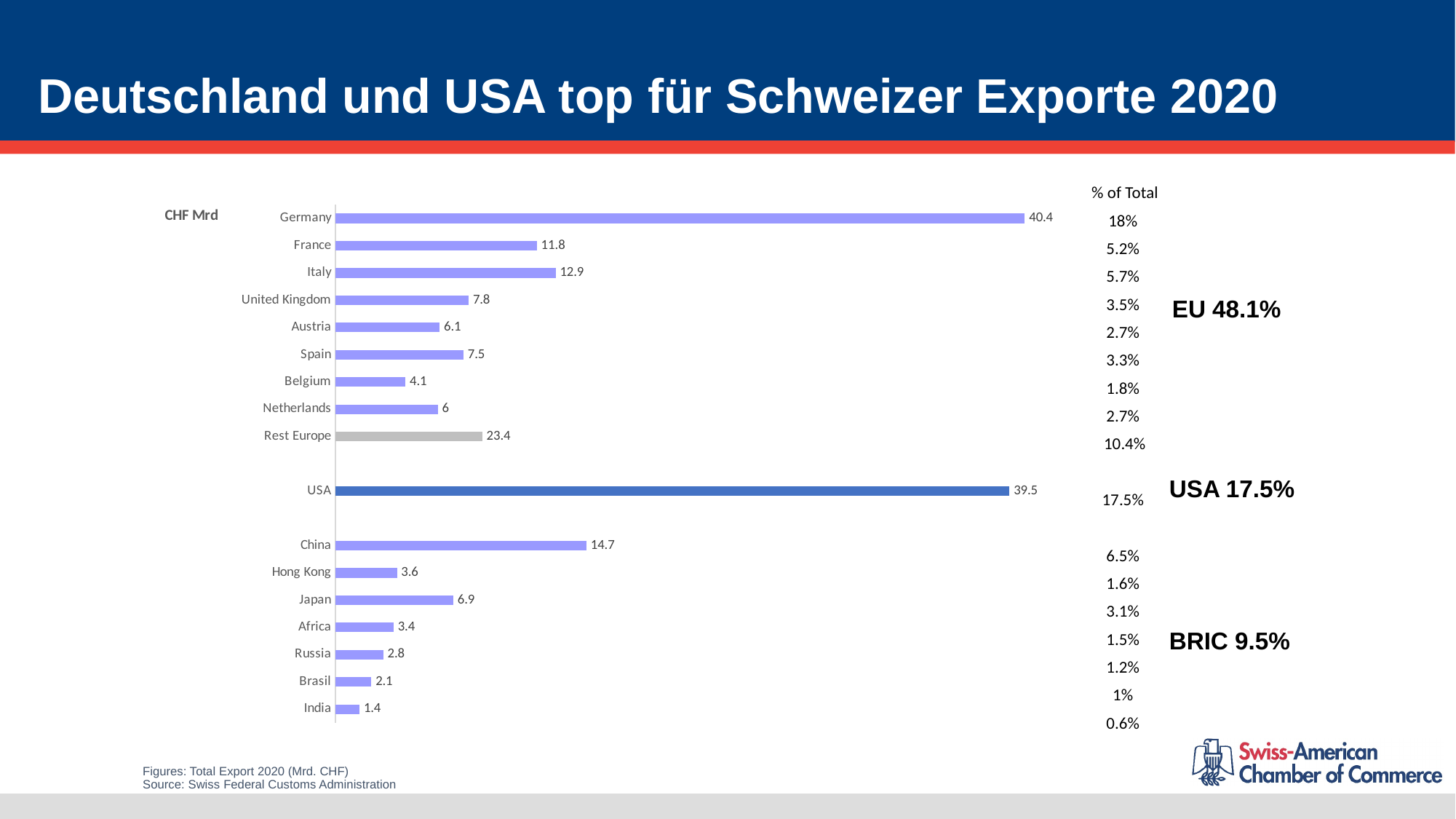
What is the difference between the export values for Germany and the USA? 0.9 What is the export value for the USA in CHF Mrd? 39.5 What is the export value for China in CHF Mrd? 14.7 What is the export value for Germany in CHF Mrd? 40.4 Which category has the lowest export value on the chart? India How many bars are plotted on the chart? 17 Which has a larger export value, France or Italy? Italy Which country has the highest export value on the chart? Germany Which bar on the chart is coloured grey rather than blue? Rest Europe What is the difference between the export values for Italy and France? 1.1 Which has a larger export value, Spain or United Kingdom? United Kingdom What kind of chart is shown on the slide? Bar chart